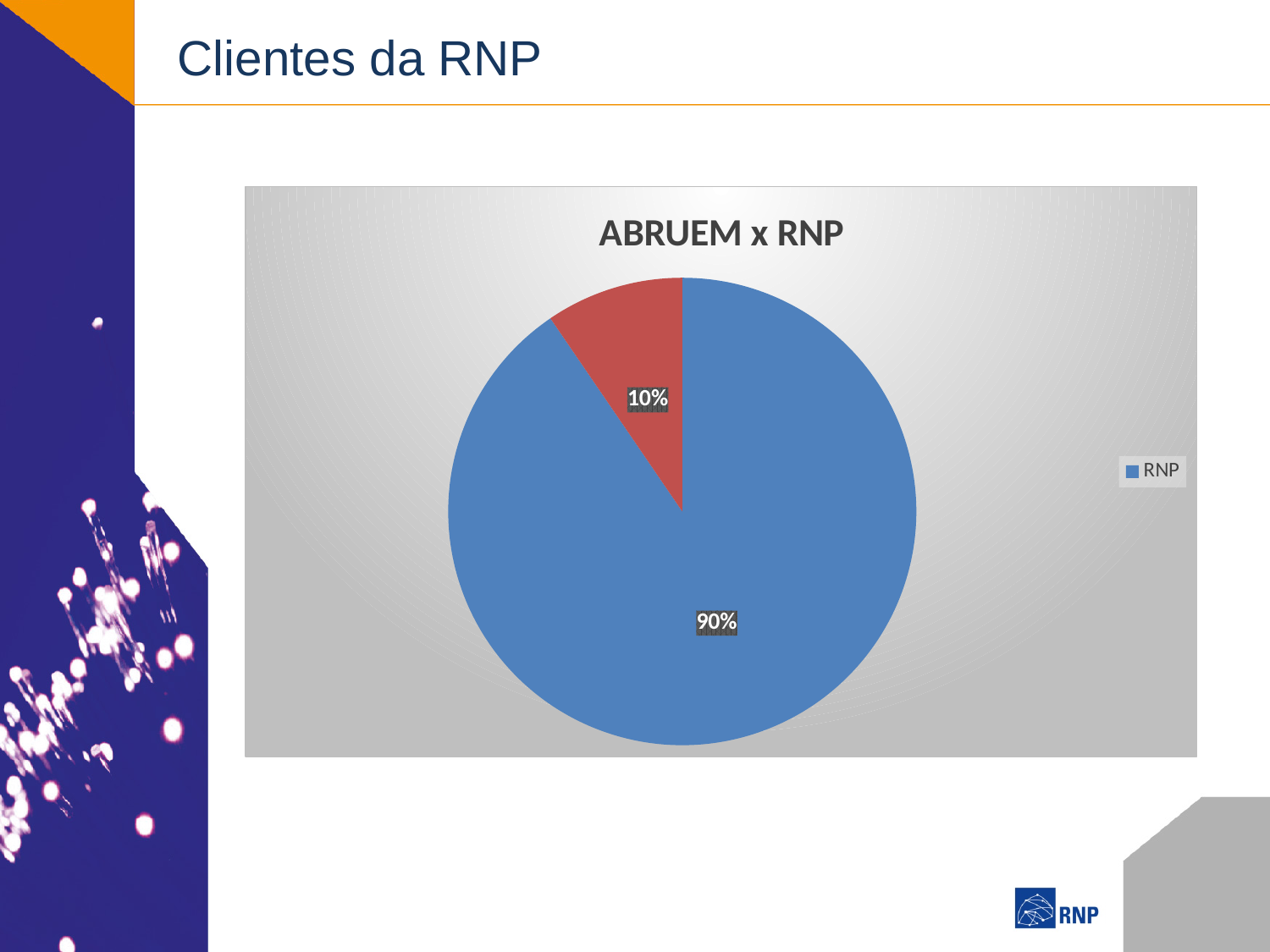
What is the difference in percentage points between the blue slice and the red slice? 80 What is the title of the chart? ABRUEM x RNP Which is larger, the blue slice or the red slice? the blue slice What is the percentage shown on the smallest slice? 10% What is the value printed on the blue slice? 90% What share of the pie does the red slice represent? 10% What colour is the RNP slice in the pie chart? blue How many slices does the pie chart have? 2 What kind of chart is shown on the slide? pie chart Which slice is the largest in the pie chart? RNP How many entries does the legend list? 1 What share of the pie does the RNP slice represent? 90%